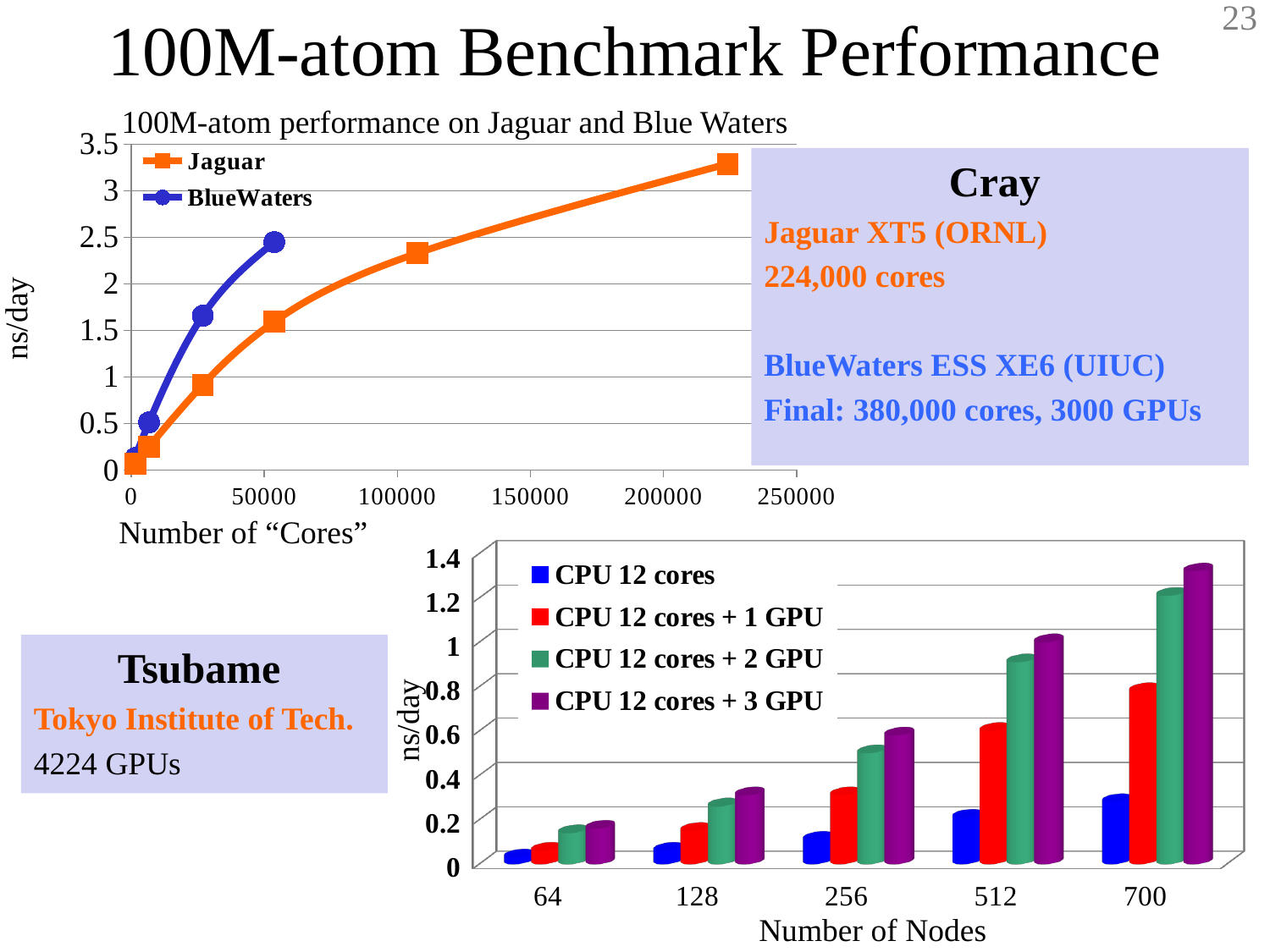
In the bottom bar chart, how many node-count categories are shown on the x axis? 5 In the bottom bar chart, do the values for each series rise or fall as the number of nodes increases? rise What kind of chart is the top chart "100M-atom performance on Jaguar and Blue Waters"? line chart In the top chart, at around 27,000 cores, which series has the higher ns/day value, Jaguar or BlueWaters? BlueWaters In the top chart "100M-atom performance on Jaguar and Blue Waters", how many series does the legend list? 2 In the bottom bar chart, which series and node count has the highest bar? CPU 12 cores + 3 GPU at 700 nodes In the top chart, is the highest Jaguar value (at about 224,000 cores) greater or less than 3? greater In the bottom bar chart, how many series does the legend list? 4 What kind of chart is the bottom chart titled with the x axis "Number of Nodes"? bar chart In the bottom bar chart, is the value for CPU 12 cores + 3 GPU at 700 nodes greater or less than 1.2? greater In the top chart, what is the label of the y axis? ns/day In the bottom bar chart, is the value for CPU 12 cores + 2 GPU at 512 nodes greater or less than 0.8? greater